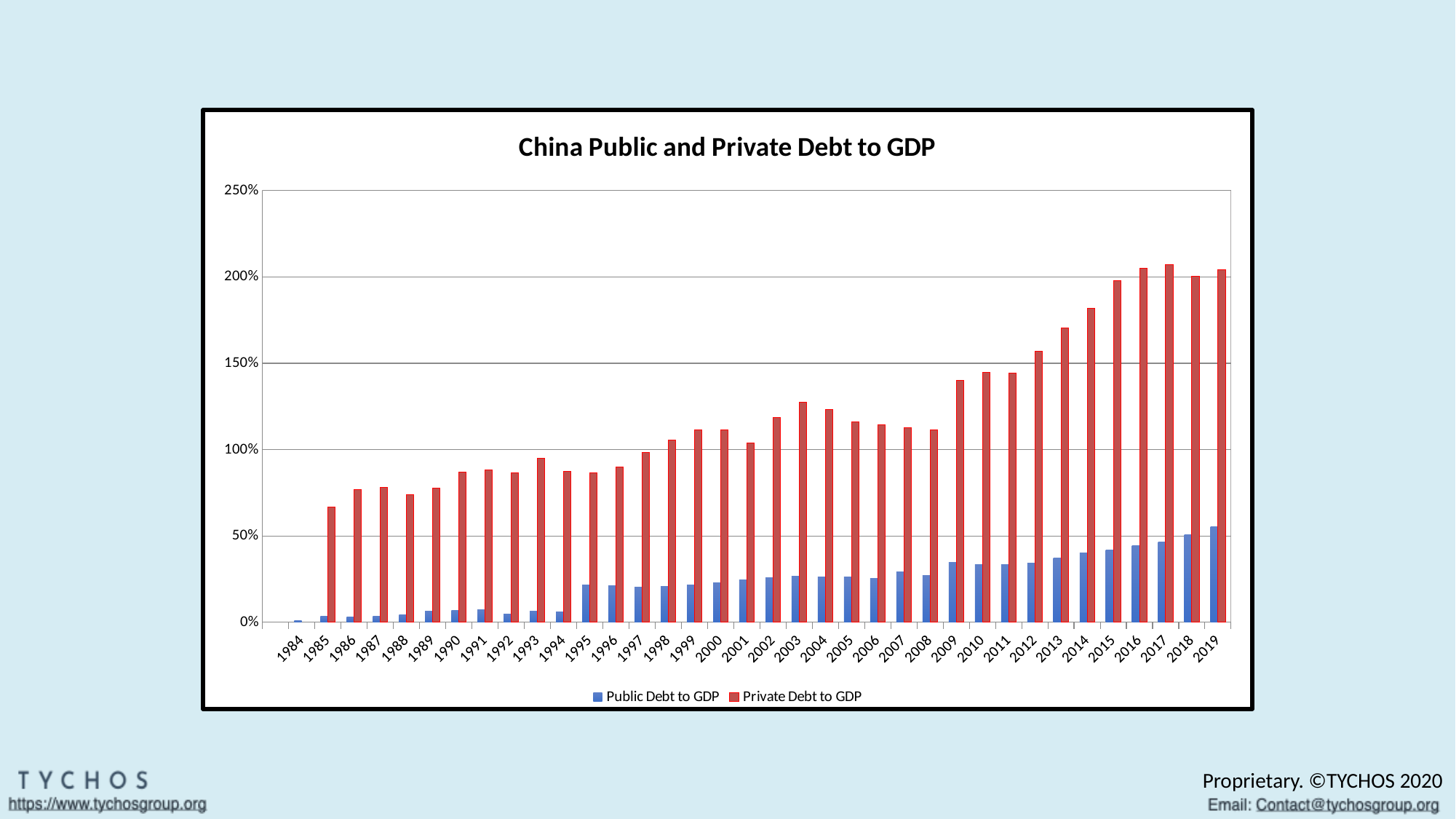
Is the Private Debt to GDP value for 2013 greater or less than 150%? greater Which is larger, Private Debt to GDP in 2003 or in 2008? 2003 What is the title of the chart? China Public and Private Debt to GDP Is the Public Debt to GDP value for 2010 greater or less than 50%? less Is the Private Debt to GDP value for 2003 greater or less than 100%? greater Which is larger, Private Debt to GDP in 2012 or in 2011? 2012 How many series does the legend list? 2 Which year has the highest Public Debt to GDP? 2019 Does Public Debt to GDP generally rise or fall from 1984 to 2019? Rise What type of chart is shown on the slide? Bar chart How many years are shown on the x axis? 36